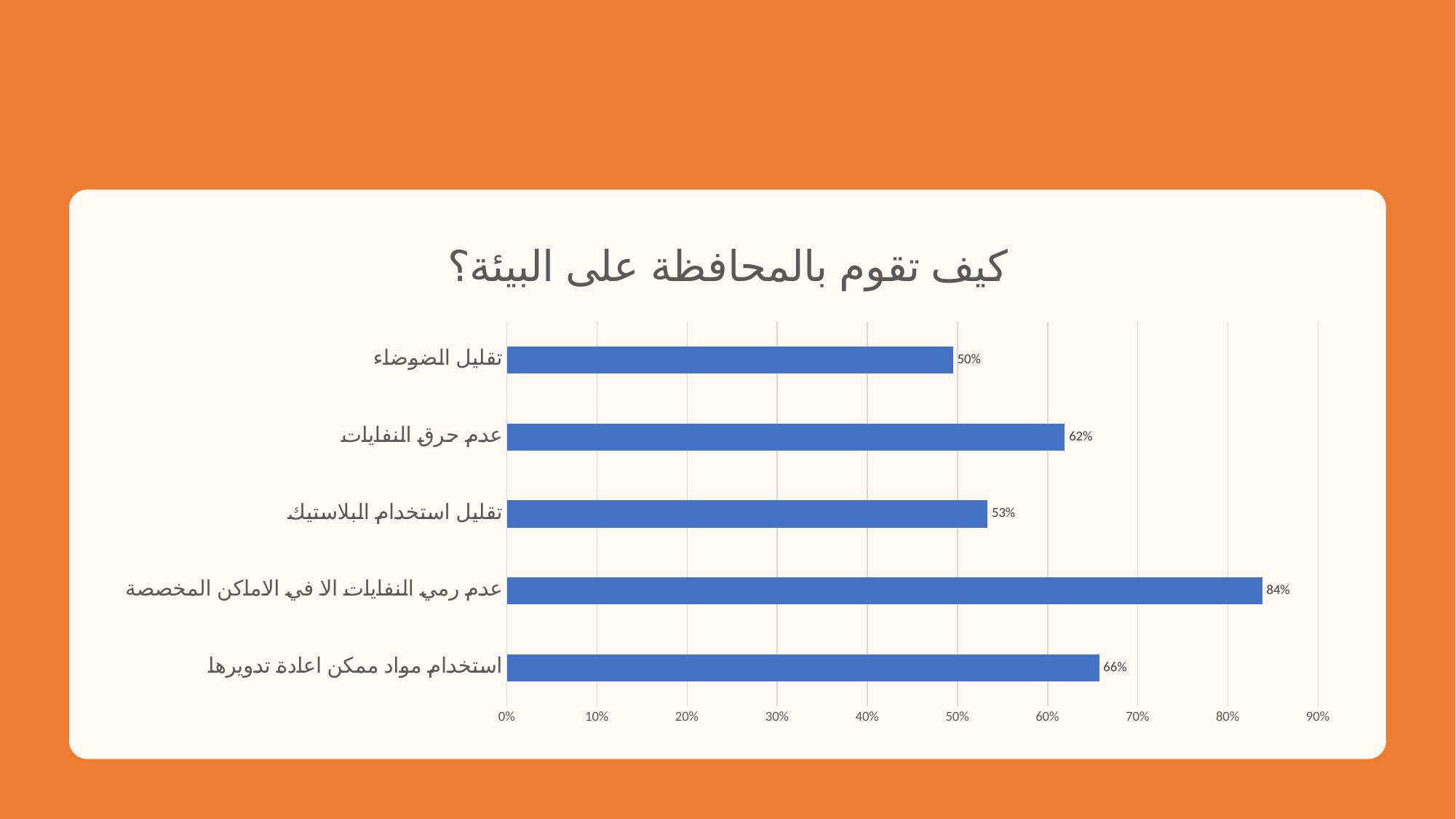
What is the value for استخدام مواد ممكن اعادة تدويرها? 66% What is the value for تقليل الضوضاء? 50% What is the value for تقليل استخدام البلاستيك? 53% What kind of chart is shown on the slide? bar chart Which category has the highest value? عدم رمي النفايات الا في الاماكن المخصصة What is the value for عدم حرق النفايات? 62% How many categories are shown in the chart? 5 Which category has the lowest value? تقليل الضوضاء Is the value for عدم رمي النفايات الا في الاماكن المخصصة greater or less than 80%? greater What is the difference between the values for عدم رمي النفايات الا في الاماكن المخصصة and تقليل الضوضاء? 34% Which is larger, the value for عدم حرق النفايات or the value for استخدام مواد ممكن اعادة تدويرها? استخدام مواد ممكن اعادة تدويرها What is the title of the chart? كيف تقوم بالمحافظة على البيئة؟